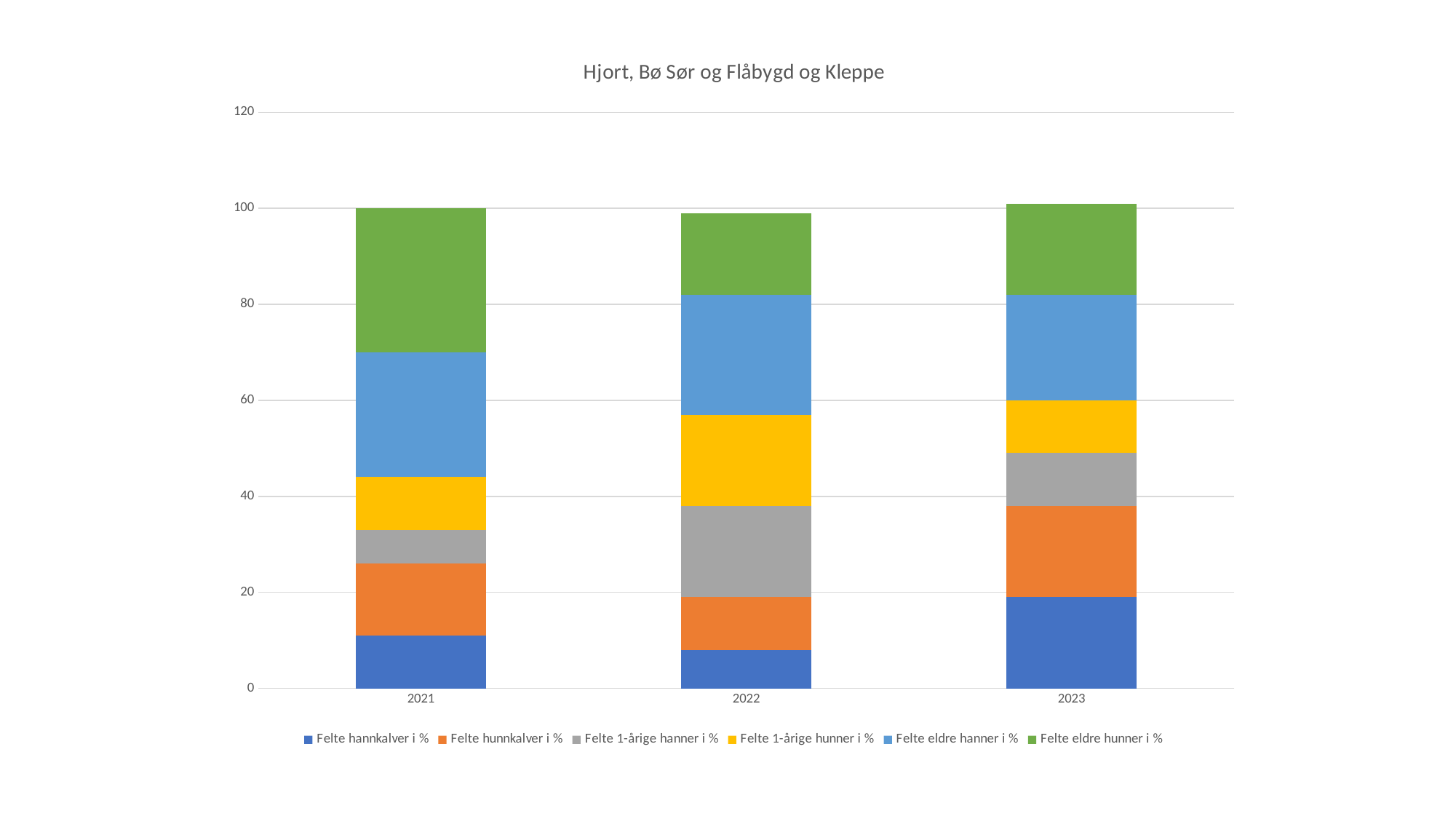
How many series does the legend list? 6 Is the value for Felte hannkalver i % in 2022 greater or less than 20? less Is the Felte 1-årige hanner i % segment larger in 2021 or in 2022? 2022 Which year has the smallest Felte hannkalver i % segment? 2022 Is the Felte hannkalver i % segment larger in 2021 or in 2023? 2023 Is the total height of the stacked bar for 2021 greater or less than 80? greater Is the value for Felte eldre hunner i % in 2021 greater or less than 20? greater Which series is shown in green in the chart? Felte eldre hunner i % What is the title of the chart? Hjort, Bø Sør og Flåbygd og Kleppe How many years are shown on the x axis of the chart? 3 What kind of chart is shown on the slide? Stacked bar chart Which year has the largest Felte eldre hunner i % segment? 2021